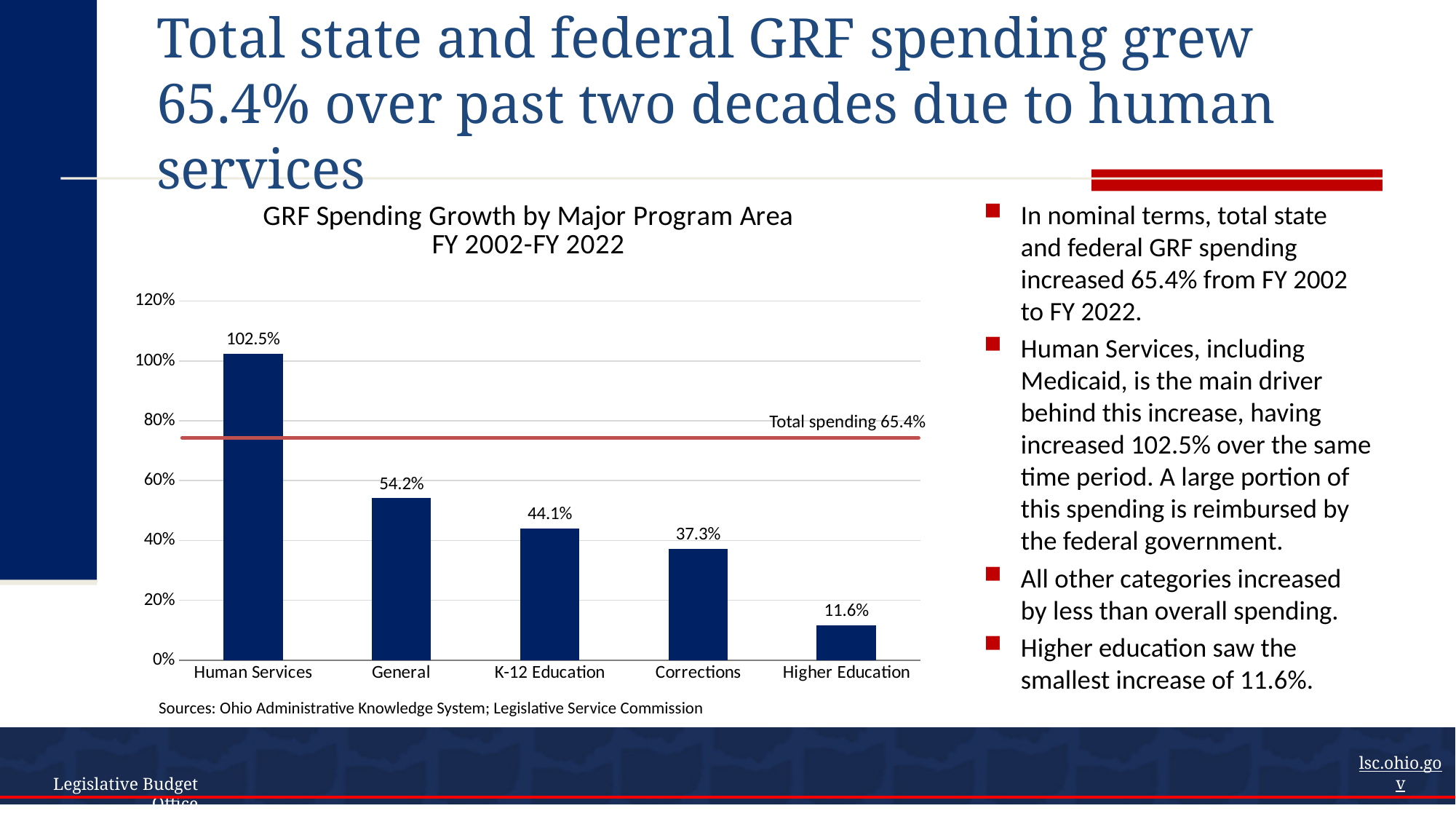
What is the GRF spending growth for K-12 Education? 44.1% Is the value for K-12 Education greater or less than 60%? less What is the GRF spending growth for Human Services? 102.5% What value does the horizontal red line in the chart represent? Total spending 65.4% What kind of chart is shown on the slide? Bar chart What is the title of the chart? GRF Spending Growth by Major Program Area FY 2002-FY 2022 Which program area has the highest spending growth? Human Services Which program area has the lowest spending growth? Higher Education What is the difference between the growth for General and the growth for Higher Education? 42.6% Which has higher spending growth, General or Corrections? General What is the GRF spending growth for Corrections? 37.3% How many program areas are shown in the chart? 5